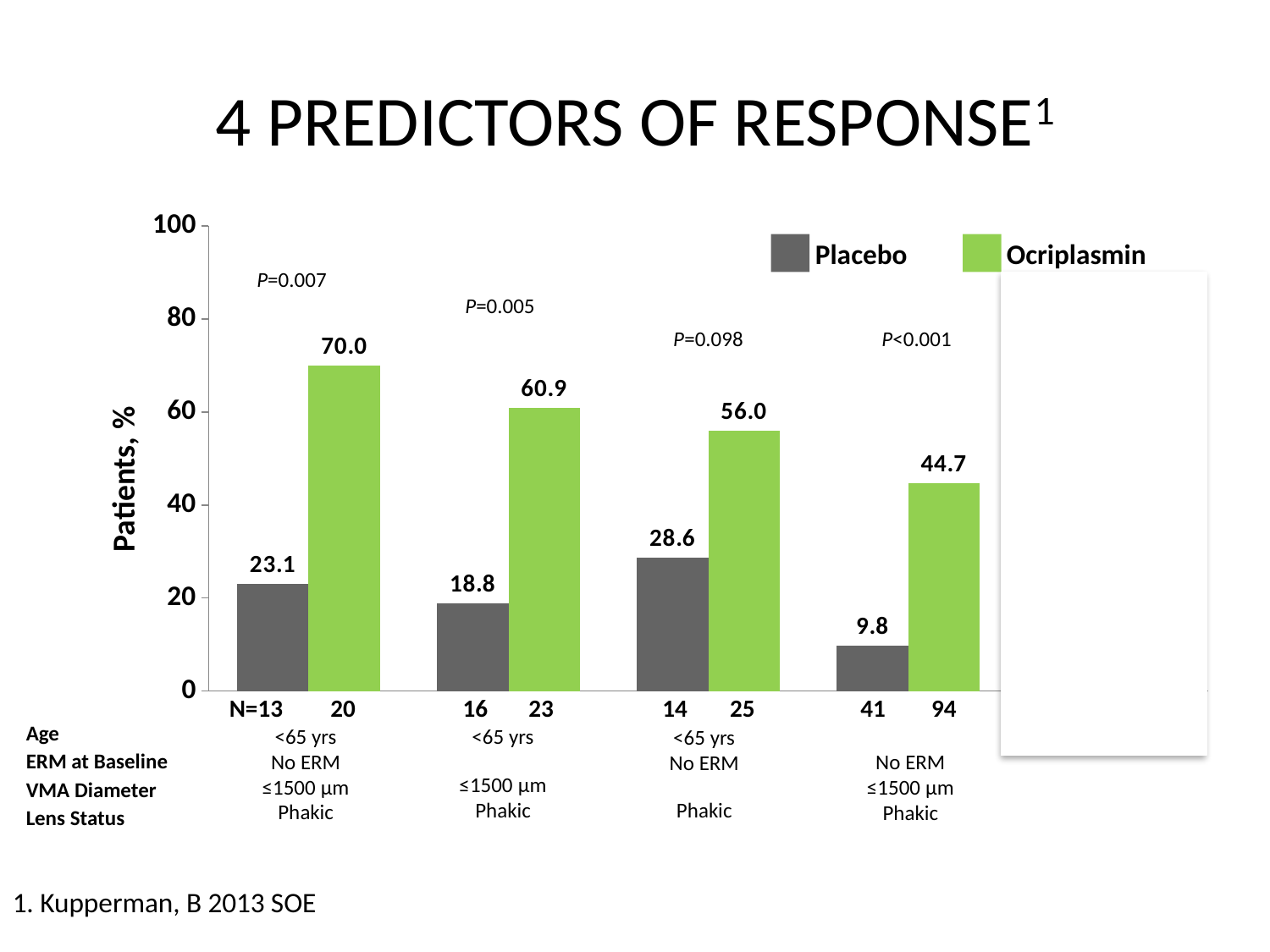
What is the Ocriplasmin value for the first (leftmost) group of bars? 70.0 Which group of bars has the lowest Placebo value? The fourth (rightmost) group What type of chart is shown on the slide? Bar chart How many series does the legend list? 2 What is the label of the y-axis? Patients, % What is the Placebo value for the fourth (rightmost) group of bars? 9.8 What is the Placebo value for the third group of bars? 28.6 Which group of bars has the highest Ocriplasmin value? The first (leftmost) group What is the difference between the Ocriplasmin and Placebo values in the second group of bars? 42.1 In the third group of bars, which is larger, the Placebo value or the Ocriplasmin value? Ocriplasmin How many groups of bars are plotted on the chart? 4 Do the Ocriplasmin values rise or fall from left to right across the groups? Fall